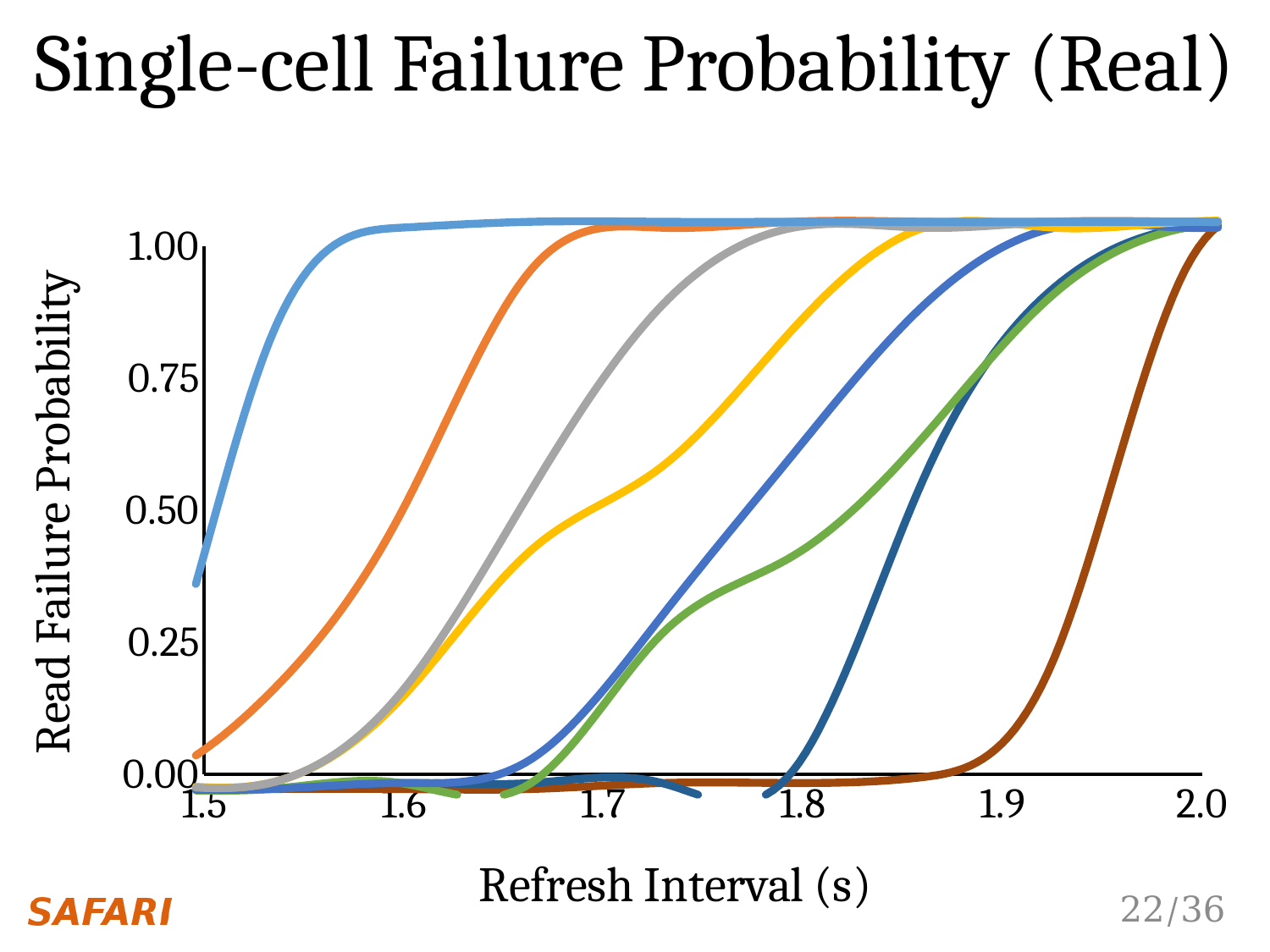
What is the title of the chart on the slide? Single-cell Failure Probability (Real) Is the value of the gray line at a refresh interval of 1.8 s greater or less than 0.75? greater What is the label of the x axis? Refresh Interval (s) How many lines are plotted in the chart? 8 Which line reaches a read failure probability of 1.00 at the smallest refresh interval? light blue line Is the value of the brown line at a refresh interval of 1.9 s greater or less than 0.25? less What kind of chart is shown on the slide? line chart Is the value of the light blue line at a refresh interval of 1.6 s greater or less than 0.75? greater At a refresh interval of 1.7 s, which line is higher: the orange line or the brown line? orange line Do the lines rise or fall as the refresh interval increases along the x axis? rise